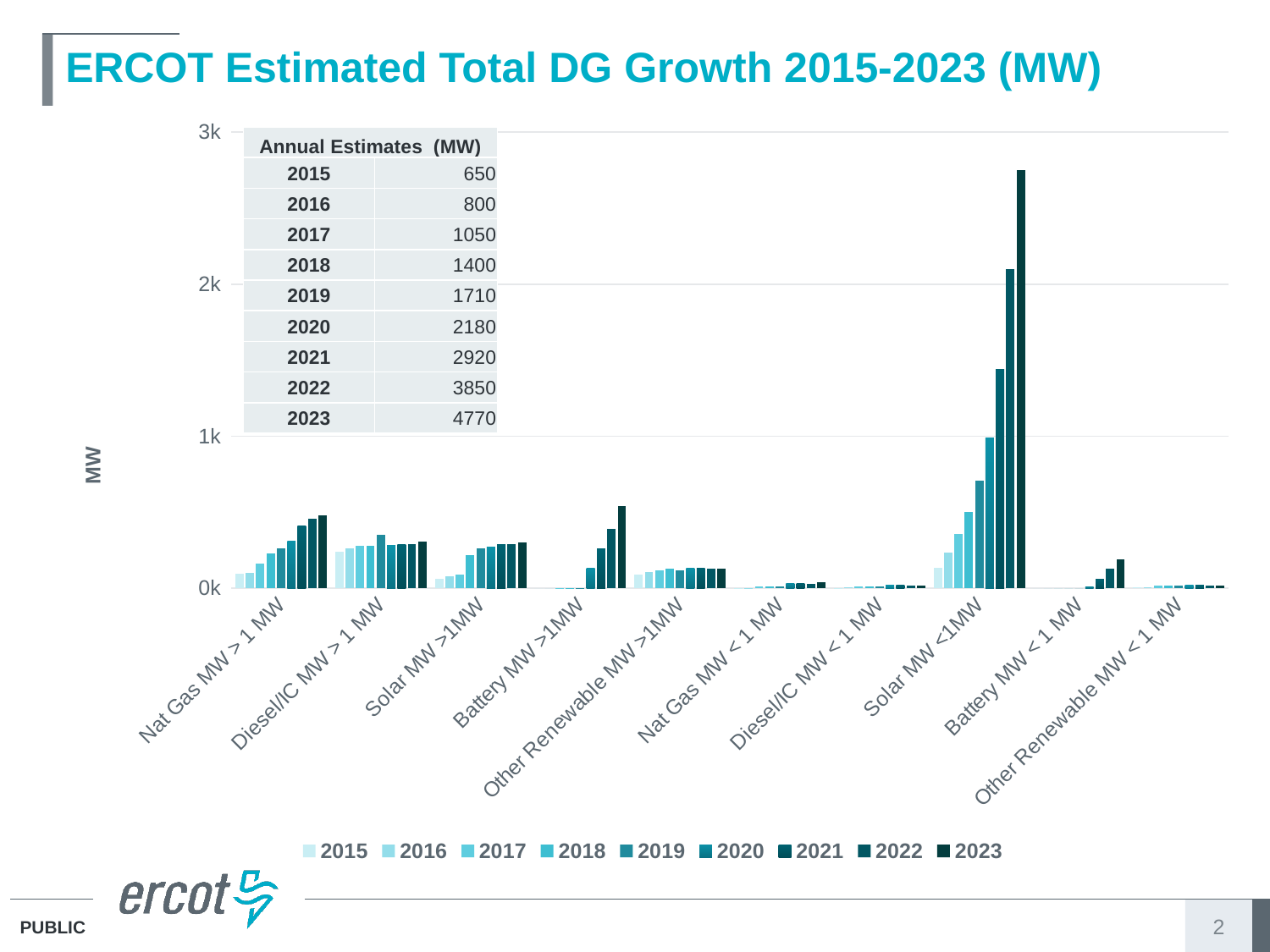
Which category has the tallest bar in the chart? Solar MW <1MW How many series does the legend list? 9 What is the label on the y axis of the chart? MW What is the difference between the 2023 and 2015 values in the Annual Estimates (MW) table? 4120 Is the 2023 value for Nat Gas MW > 1 MW greater or less than 1k? less What kind of chart is shown on the slide? bar chart Do the bars for Solar MW <1MW rise or fall from 2015 to 2023? rise Is the 2023 value for Solar MW <1MW greater or less than 2k? greater Which is larger, the 2023 bar for Solar MW <1MW or the 2023 bar for Battery MW >1MW? Solar MW <1MW How many categories are shown along the x axis? 10 According to the Annual Estimates (MW) table, what is the estimate for 2023? 4770 According to the Annual Estimates (MW) table, what is the estimate for 2015? 650